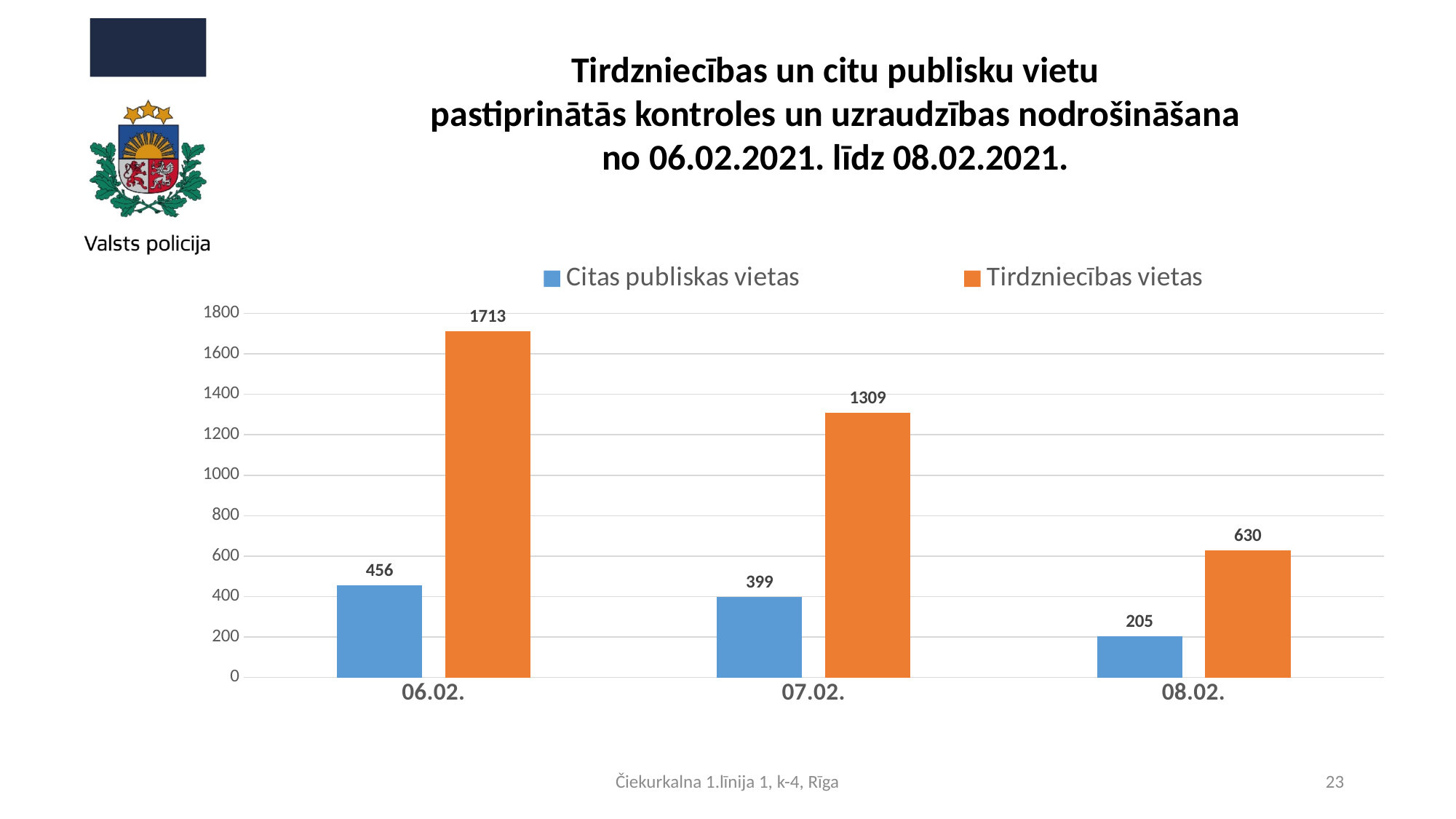
Is the value for Tirdzniecības vietas on 07.02. greater or less than 1200? greater How many dates are shown on the x axis? 3 Do the values for Tirdzniecības vietas rise or fall from 06.02. to 08.02.? fall On which date is the value for Citas publiskas vietas lowest? 08.02. On which date is the value for Tirdzniecības vietas highest? 06.02. How many series does the legend list? 2 What is the value for Citas publiskas vietas on 07.02.? 399 Which is larger on 08.02.: Citas publiskas vietas or Tirdzniecības vietas? Tirdzniecības vietas What is the value for Tirdzniecības vietas on 06.02.? 1713 What kind of chart is shown on the slide? bar chart What is the value for Citas publiskas vietas on 08.02.? 205 What is the difference between Tirdzniecības vietas and Citas publiskas vietas on 07.02.? 910